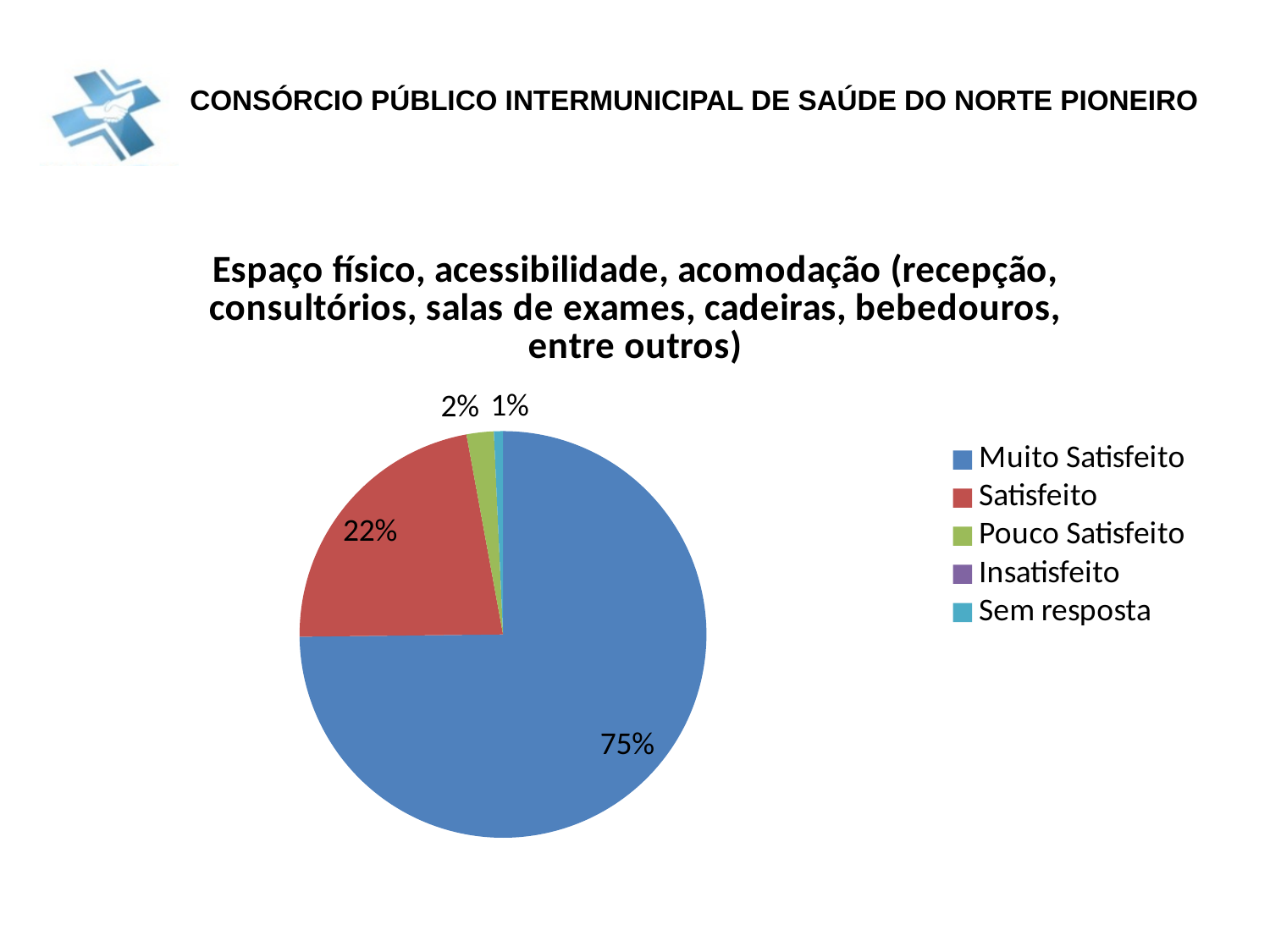
Which slice is larger, "Satisfeito" or "Pouco Satisfeito"? Satisfeito What percentage is shown for the "Satisfeito" slice? 22% Which category has the largest slice of the pie chart? Muito Satisfeito What colour is the "Muito Satisfeito" slice in the pie chart? Blue How many categories are listed in the chart legend? 5 Which legend entry is listed second in the chart legend? Satisfeito What is the difference in percentage points between "Muito Satisfeito" and "Satisfeito"? 53 percentage points What combined percentage do "Muito Satisfeito" and "Satisfeito" account for? 97% What percentage of the pie chart corresponds to "Muito Satisfeito"? 75% What type of chart is shown on the slide? Pie chart What percentage is shown for "Sem resposta"? 1% What percentage is shown for "Pouco Satisfeito"? 2%